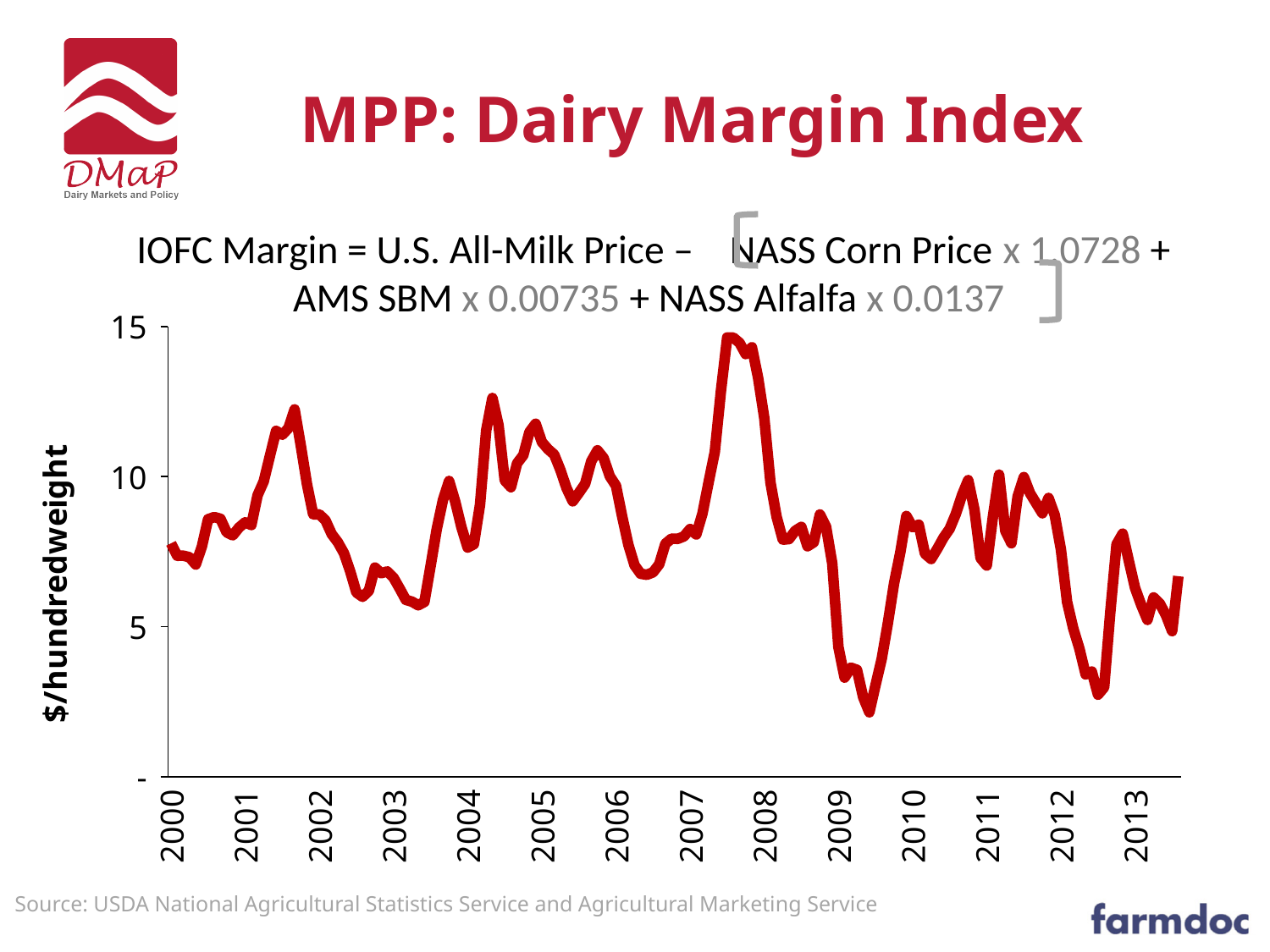
Is the lowest value of the margin in 2009 greater or less than 5? less How many year labels are shown along the x axis of the chart? 14 What is the title of the slide containing the chart? MPP: Dairy Margin Index Is the value of the margin at the start of 2000 greater or less than 5? greater In which year does the margin reach its lowest value on the chart? 2009 In which year does the margin reach its highest value on the chart? 2007 Which is larger, the margin at the peak in late 2007 or the margin at the peak in 2004? the peak in late 2007 Is the value of the margin at the start of 2000 greater or less than 10? less What kind of chart is shown on the slide? line chart Does the margin rise or fall between its peak in late 2007 and early 2009? fall What is the label on the vertical axis of the chart? $/hundredweight